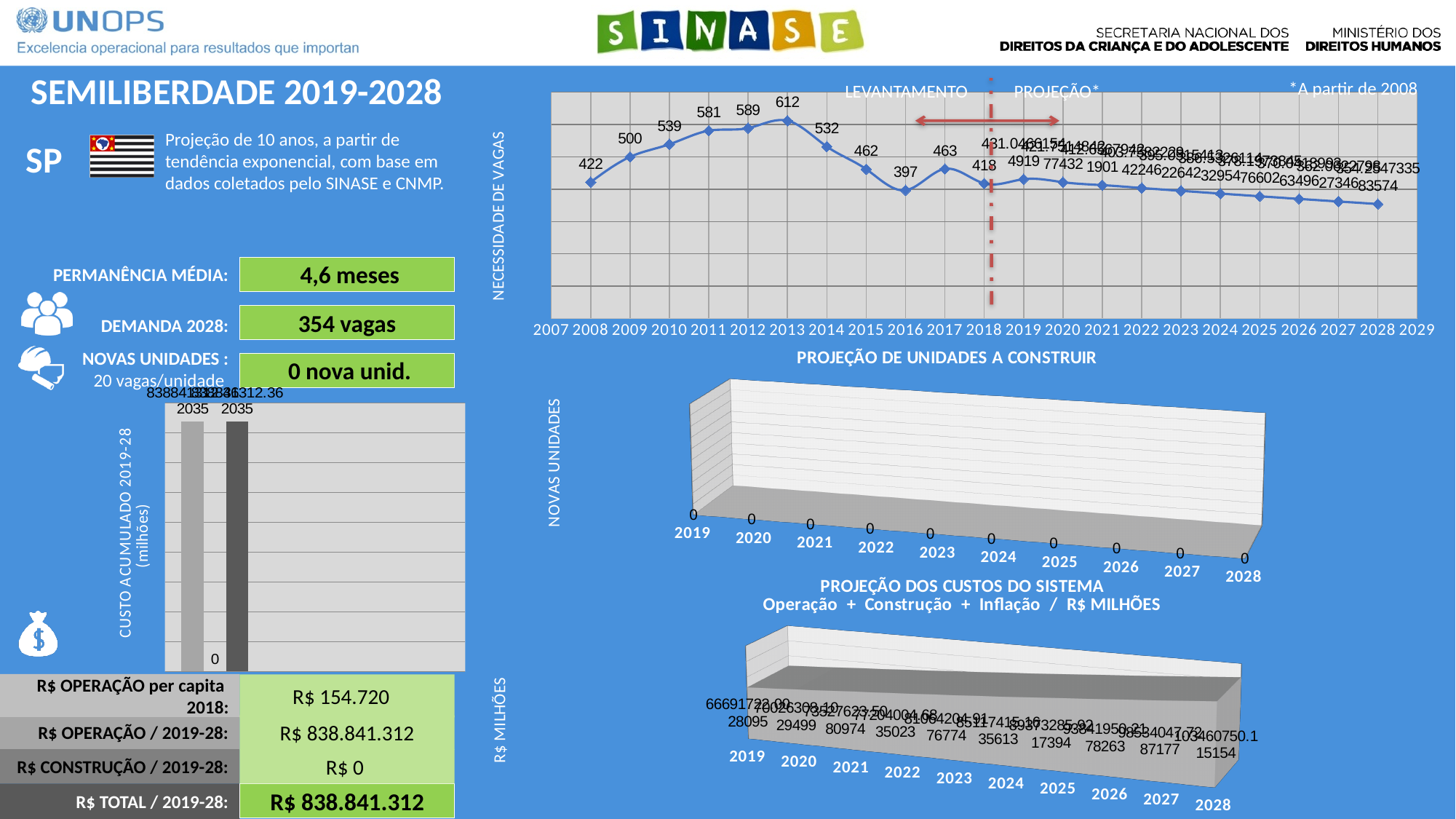
In the PROJEÇÃO DE UNIDADES A CONSTRUIR chart, what is the value for 2025? 0 In the PROJEÇÃO DE UNIDADES A CONSTRUIR chart, how many years are shown on the x axis? 10 What is the title of the chart at the bottom right of the slide? PROJEÇÃO DOS CUSTOS DO SISTEMA In the NECESSIDADE DE VAGAS line chart, what is the value for 2018? 418 In the NECESSIDADE DE VAGAS line chart, what is the value for 2013? 612 In the NECESSIDADE DE VAGAS line chart, what is the value for 2008? 422 In the NECESSIDADE DE VAGAS line chart, which year has the larger value, 2011 or 2015? 2011 In the NECESSIDADE DE VAGAS line chart, what is the value for 2016? 397 What kind of chart is the top-right chart labelled NECESSIDADE DE VAGAS? line chart In the NECESSIDADE DE VAGAS line chart, which year has the highest value? 2013 In the NECESSIDADE DE VAGAS line chart, do the values rise or fall from 2008 to 2013? rise In the NECESSIDADE DE VAGAS line chart, what is the difference between the values for 2013 and 2008? 190